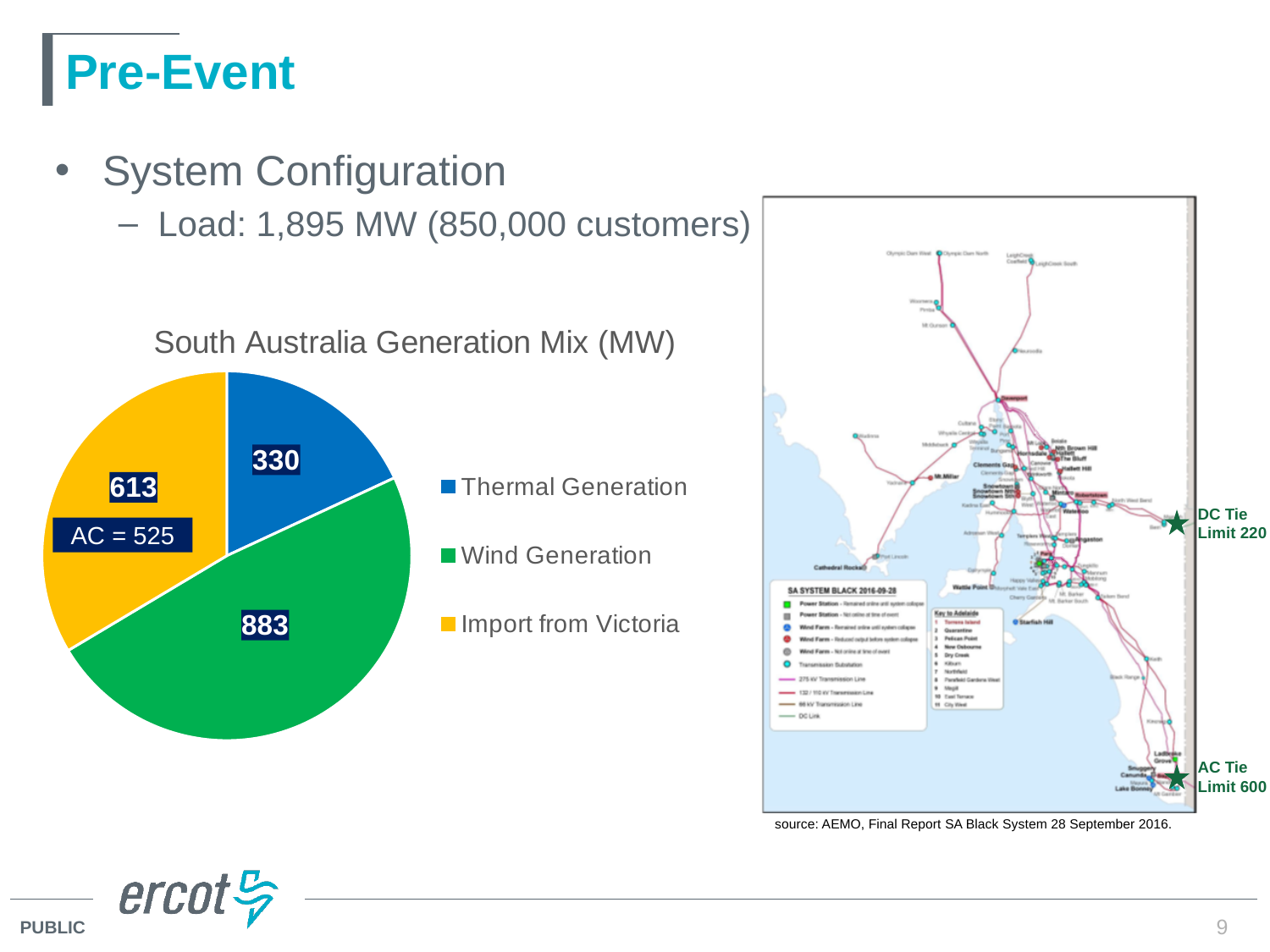
What is the difference between Wind Generation and Thermal Generation in the pie chart? 553 What is the value for Import from Victoria in the pie chart? 613 What is the value for Thermal Generation in the pie chart? 330 Which category has the smallest slice in the pie chart? Thermal Generation How many slices does the pie chart have? 3 Which colour represents Import from Victoria in the pie chart? Yellow What type of chart is shown on the slide? Pie chart What is the value for Wind Generation in the pie chart? 883 Which is larger in the pie chart, Import from Victoria or Thermal Generation? Import from Victoria Which category has the largest slice in the pie chart? Wind Generation How many entries does the chart legend list? 3 What is the title of the chart? South Australia Generation Mix (MW)